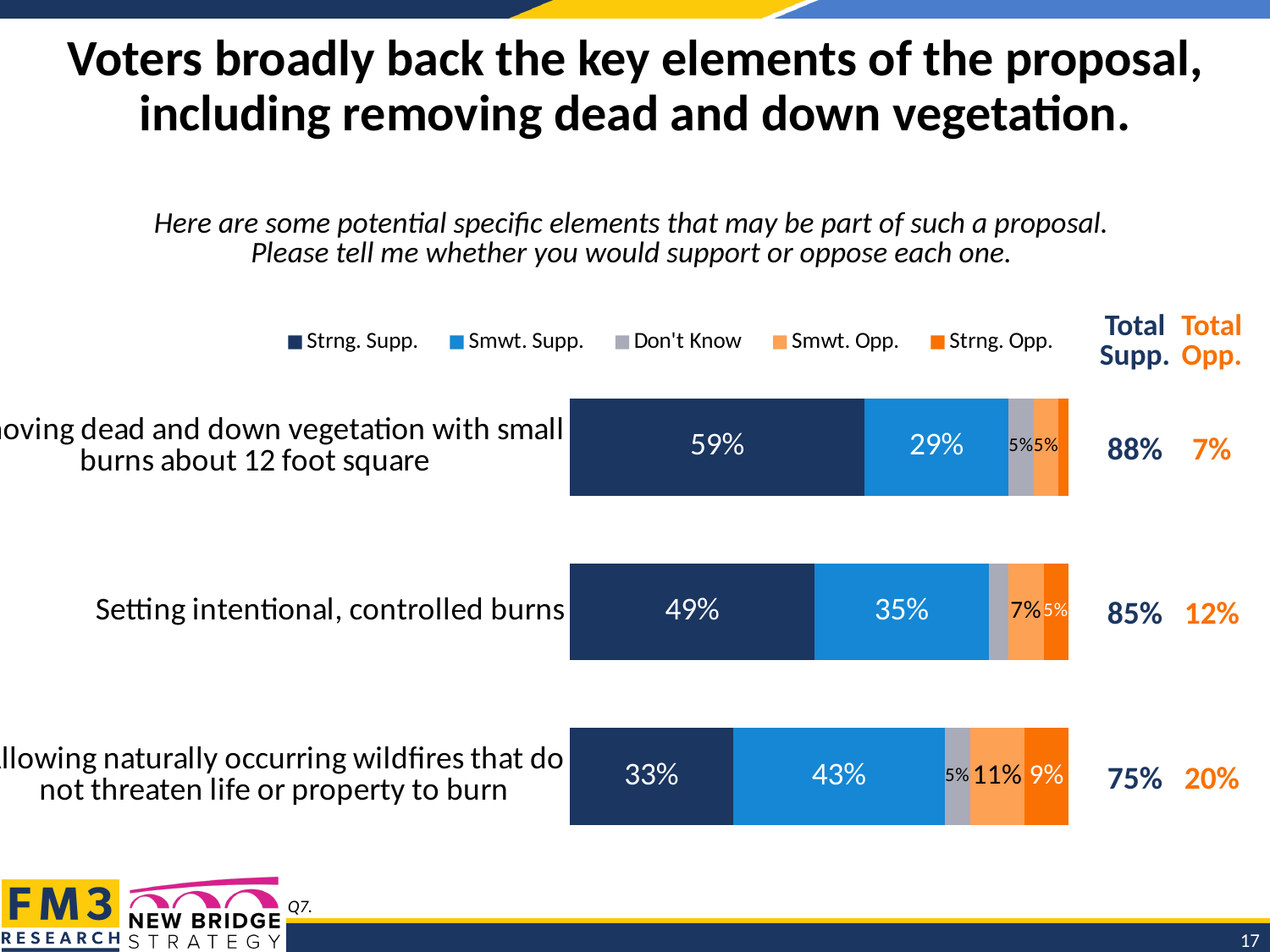
Which is larger: the Smwt. Supp. share for setting intentional, controlled burns or for allowing naturally occurring wildfires to burn? Allowing naturally occurring wildfires to burn What kind of chart is shown on the slide? Stacked bar chart What is the Total Supp. value for setting intentional, controlled burns? 85% Which proposal element has the highest Strng. Supp. percentage? Removing dead and down vegetation with small burns about 12 foot square Which proposal element has the lowest Total Supp. value? Allowing naturally occurring wildfires that do not threaten life or property to burn What is the difference between the Total Supp. for removing dead and down vegetation and the Total Supp. for allowing naturally occurring wildfires to burn? 13 percentage points What percentage somewhat support setting intentional, controlled burns? 35% How many proposal elements are shown in the chart? 3 What is the difference in Strng. Supp. between removing dead and down vegetation and setting intentional, controlled burns? 10 percentage points What is the Total Opp. value for allowing naturally occurring wildfires that do not threaten life or property to burn? 20% How many series does the legend list? 5 What percentage strongly support removing dead and down vegetation with small burns about 12 foot square? 59%